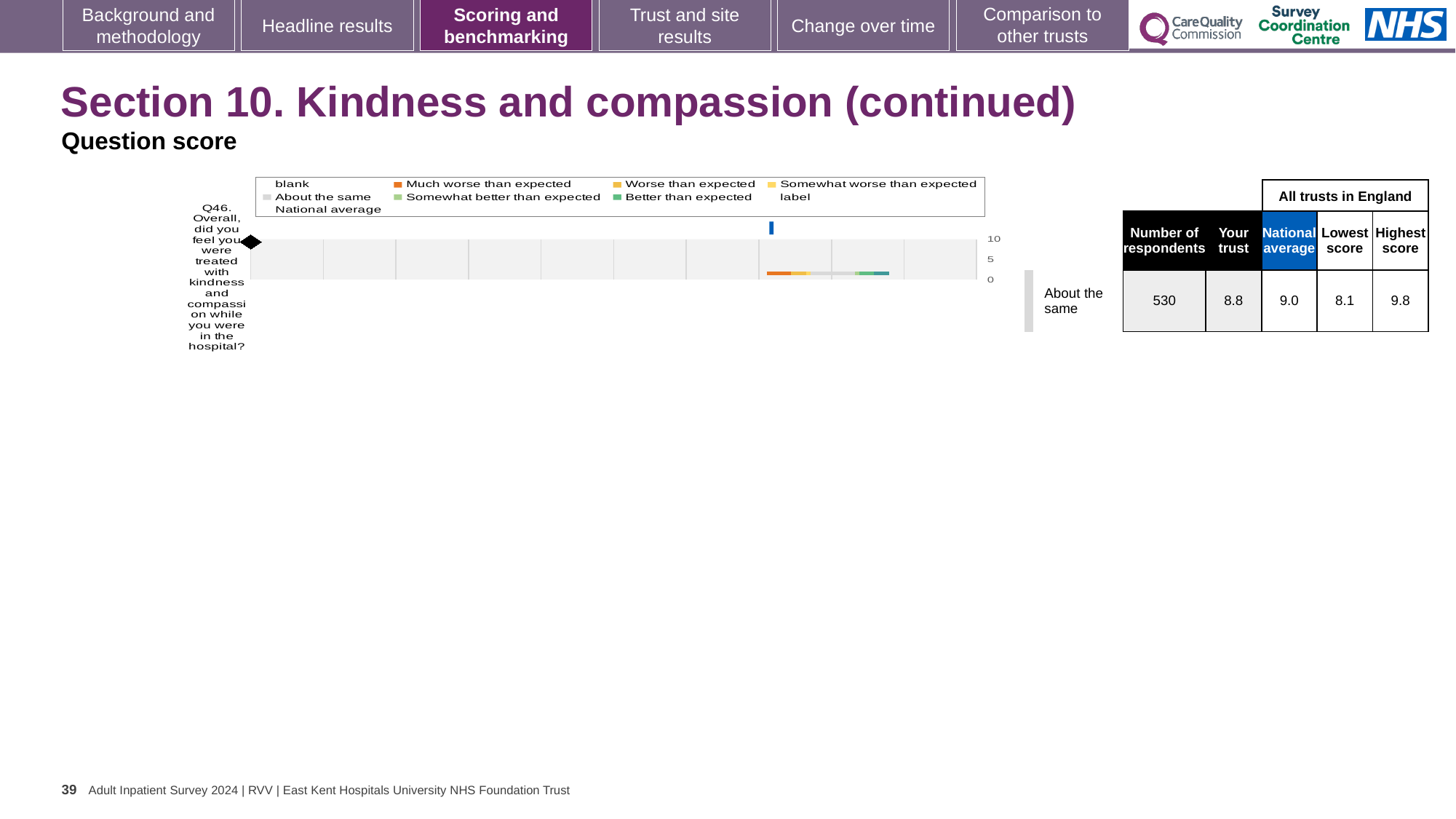
How is the trust's result for Q46 categorised relative to expectations? About the same What is the lowest score among all trusts in England for Q46? 8.1 What is the national average score for Q46? 9.0 Which is larger for Q46, the 'Your trust' score or the national average? National average What is the difference between the highest and lowest scores for Q46? 1.7 What is the number of respondents shown for Q46? 530 What is the 'Your trust' score for Q46? 8.8 Which question number does the chart relate to? Q46 What is the difference between the national average and the 'Your trust' score for Q46? 0.2 What is the highest tick value shown on the chart's axis? 10 What kind of chart is shown on the slide? Bar chart What is the highest score among all trusts in England for Q46? 9.8